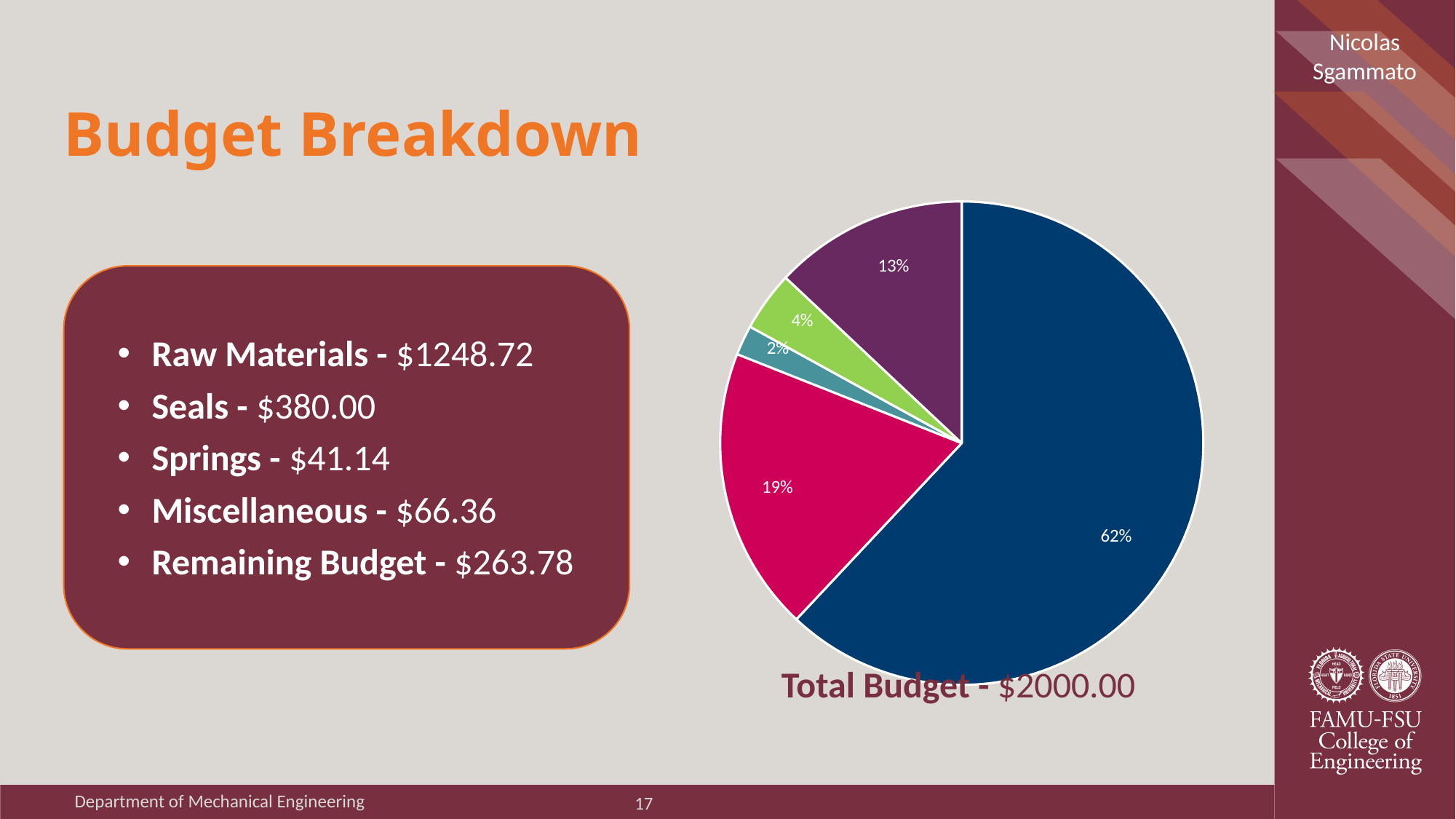
What is the share of the largest slice in the pie chart? 62% What total budget is stated in the caption below the pie chart? $2000.00 What is the share of the smallest slice in the pie chart? 2% What is the difference in percentage points between the largest slice and the second-largest slice of the pie chart? 43 How many slices does the pie chart have? 5 What kind of chart is shown on the slide? pie chart What share is shown on the teal slice of the pie chart? 2% What share is shown on the dark blue slice of the pie chart? 62% What share is shown on the green slice of the pie chart? 4% Which slice is larger in the pie chart, the purple slice or the magenta slice? the magenta slice